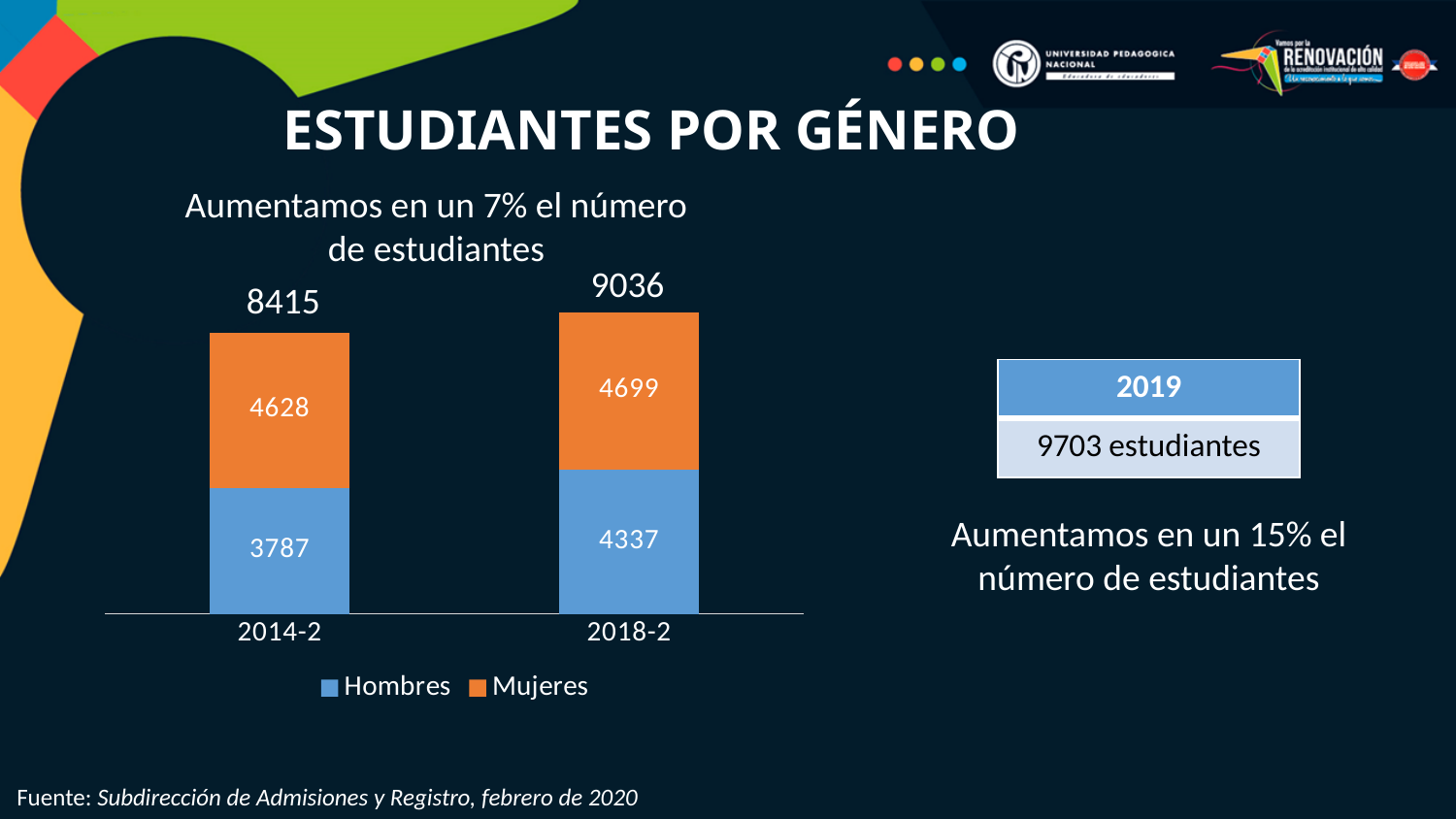
Which is larger in 2014-2, Hombres or Mujeres? Mujeres How many series does the legend list? 2 What kind of chart is shown on the slide? Stacked bar chart Which category has the higher total, 2014-2 or 2018-2? 2018-2 What is the total of the stacked bar for 2018-2? 9036 What is the value for Hombres in 2018-2? 4337 What is the value for Mujeres in 2014-2? 4628 What is the difference between the Hombres values for 2018-2 and 2014-2? 550 What is the title of the chart? Aumentamos en un 7% el número de estudiantes What is the value for Mujeres in 2018-2? 4699 What is the value for Hombres in 2014-2? 3787 What is the total of the stacked bar for 2014-2? 8415